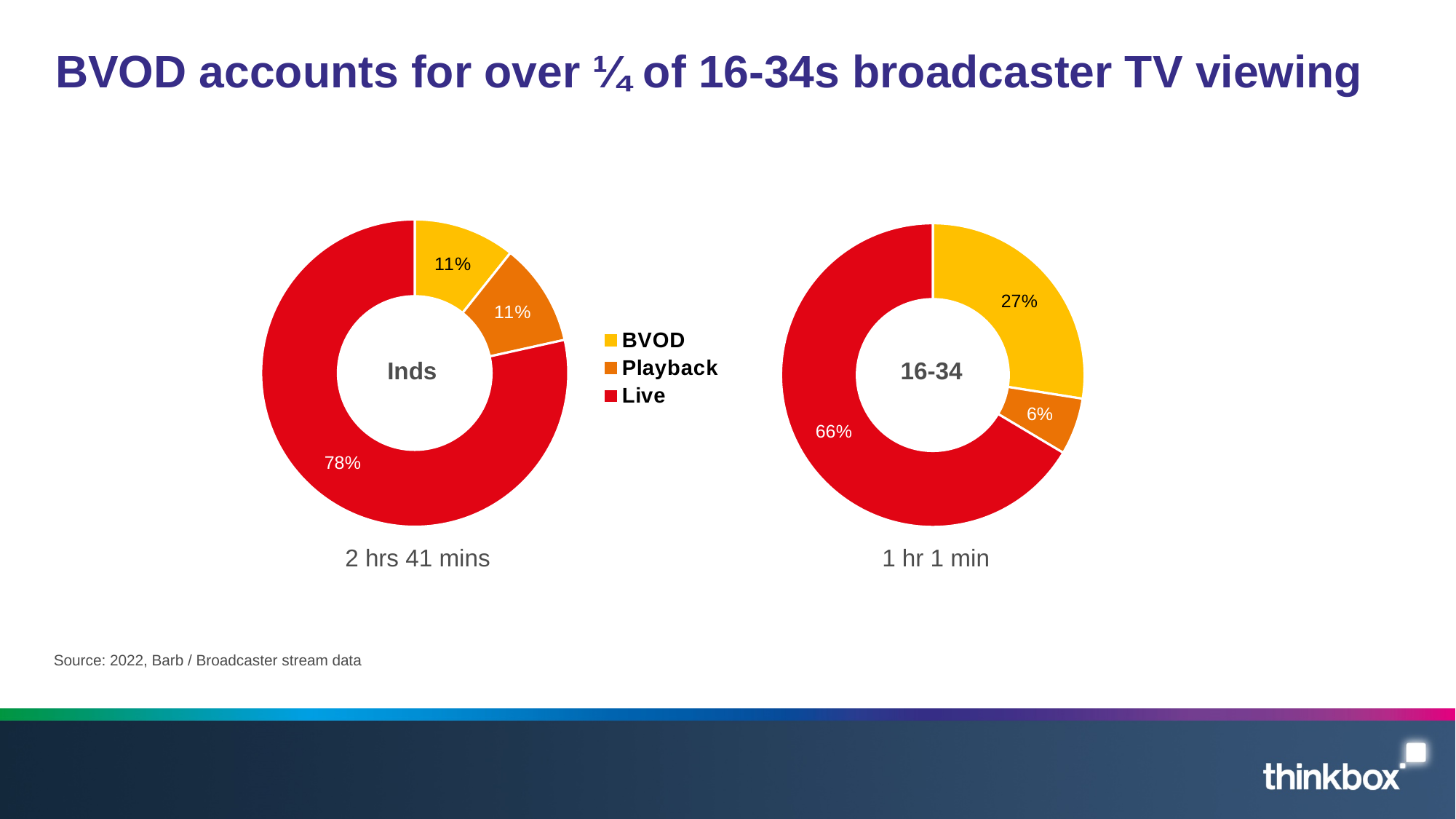
In the 16-34 donut chart, which category has the largest share? Live What total viewing time is shown beneath the 16-34 donut chart? 1 hr 1 min Which is larger: the BVOD share in the Inds chart or the BVOD share in the 16-34 chart? 16-34 In the 16-34 donut chart, what share of viewing is Playback? 6% In the 16-34 donut chart, which category has the smallest share? Playback In the Inds donut chart, what share of viewing is Live? 78% How many series does the legend list? 3 What is the difference between the Live share in the Inds chart and the Live share in the 16-34 chart? 12 percentage points What kind of chart is used on this slide? Donut (pie) chart In the Inds donut chart, which category has the largest share? Live In the 16-34 donut chart, what share of viewing is BVOD? 27% In the Inds donut chart, what share of viewing is BVOD? 11%